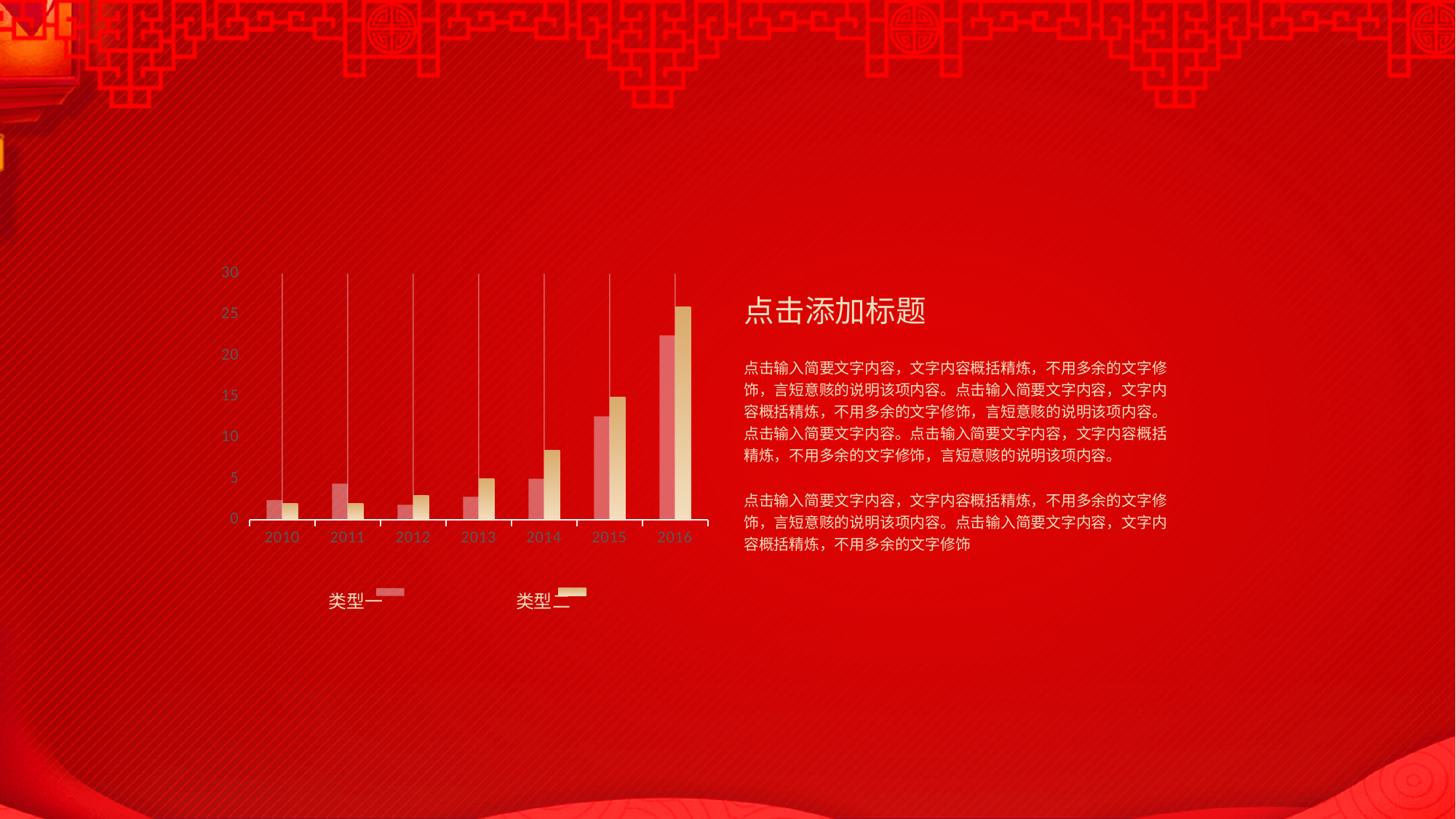
Which year has the highest value for 类型一? 2016 Do the values for 类型二 generally rise or fall from 2010 to 2016? rise In 2016, which series has the larger value, 类型一 or 类型二? 类型二 What kind of chart is shown on the slide? bar chart In 2011, which series has the larger value, 类型一 or 类型二? 类型一 How many years are shown on the x axis of the chart? 7 Is the value for 类型一 in 2015 greater or less than 10? greater How many series does the chart legend list? 2 What are the two series names listed in the chart legend? 类型一 and 类型二 Is the value for 类型二 in 2014 greater or less than 10? less Is the value for 类型二 in 2016 greater or less than 20? greater Which year has the highest value for 类型二? 2016